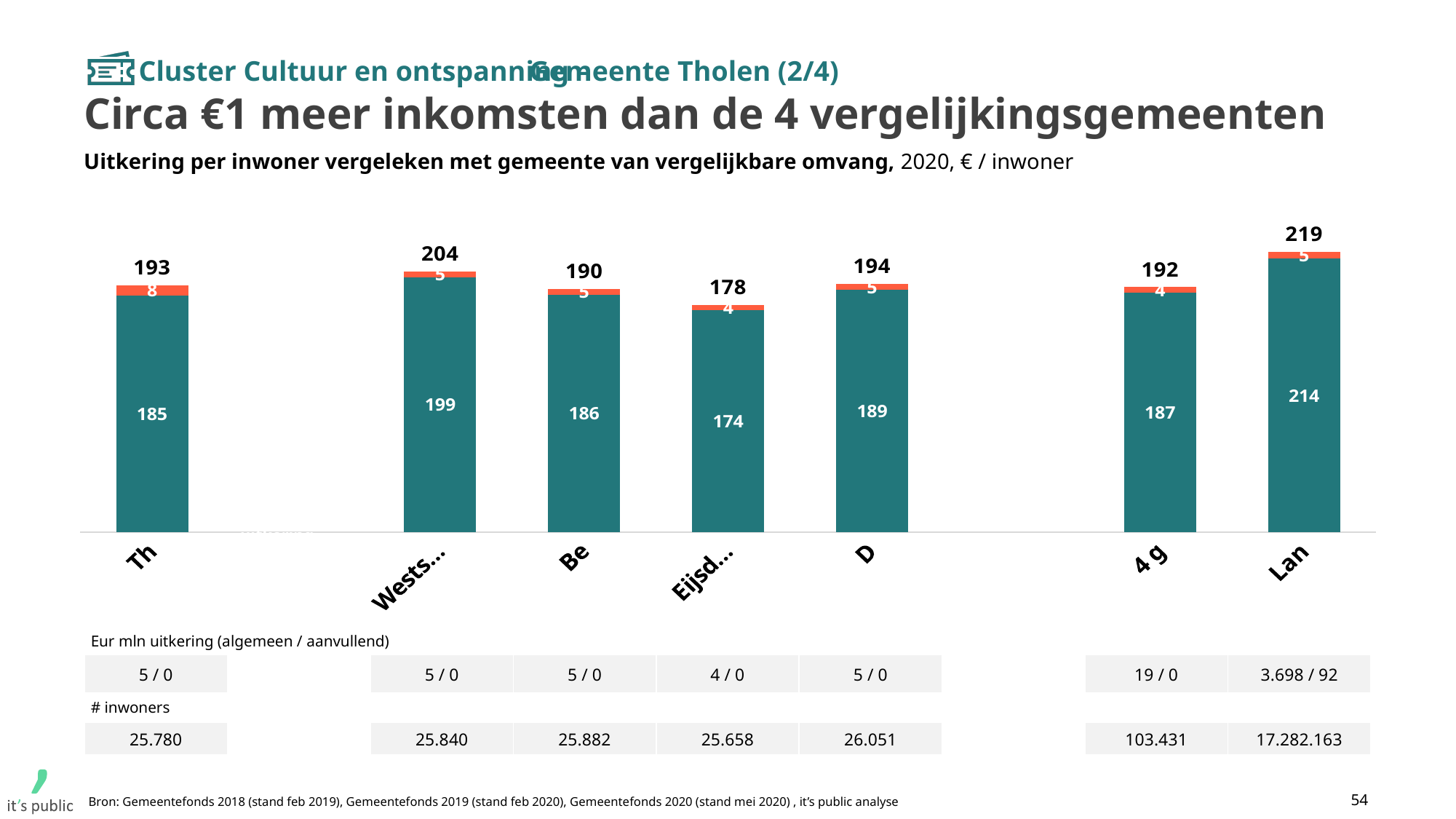
Which bar has the lowest total value? Eijsd... Which has a larger total value, 'Wests...' or 'D'? Wests... How many bars are plotted in the chart? 7 What unit is stated in the chart subtitle for the values plotted? € / inwoner What is the value of the lower (teal) segment of the bar labelled 'D'? 189 Which bar has the highest total value? Lan What is the difference between the total for 'Lan' and the total for 'Eijsd...'? 41 What kind of chart is shown on the slide? Stacked bar chart What is the total value shown above the bar labelled 'Th'? 193 What is the value of the upper (orange) segment of the bar labelled 'Th'? 8 What is the value of the lower (teal) segment of the bar labelled 'Lan'? 214 What is the total value shown above the bar labelled 'Eijsd...'? 178